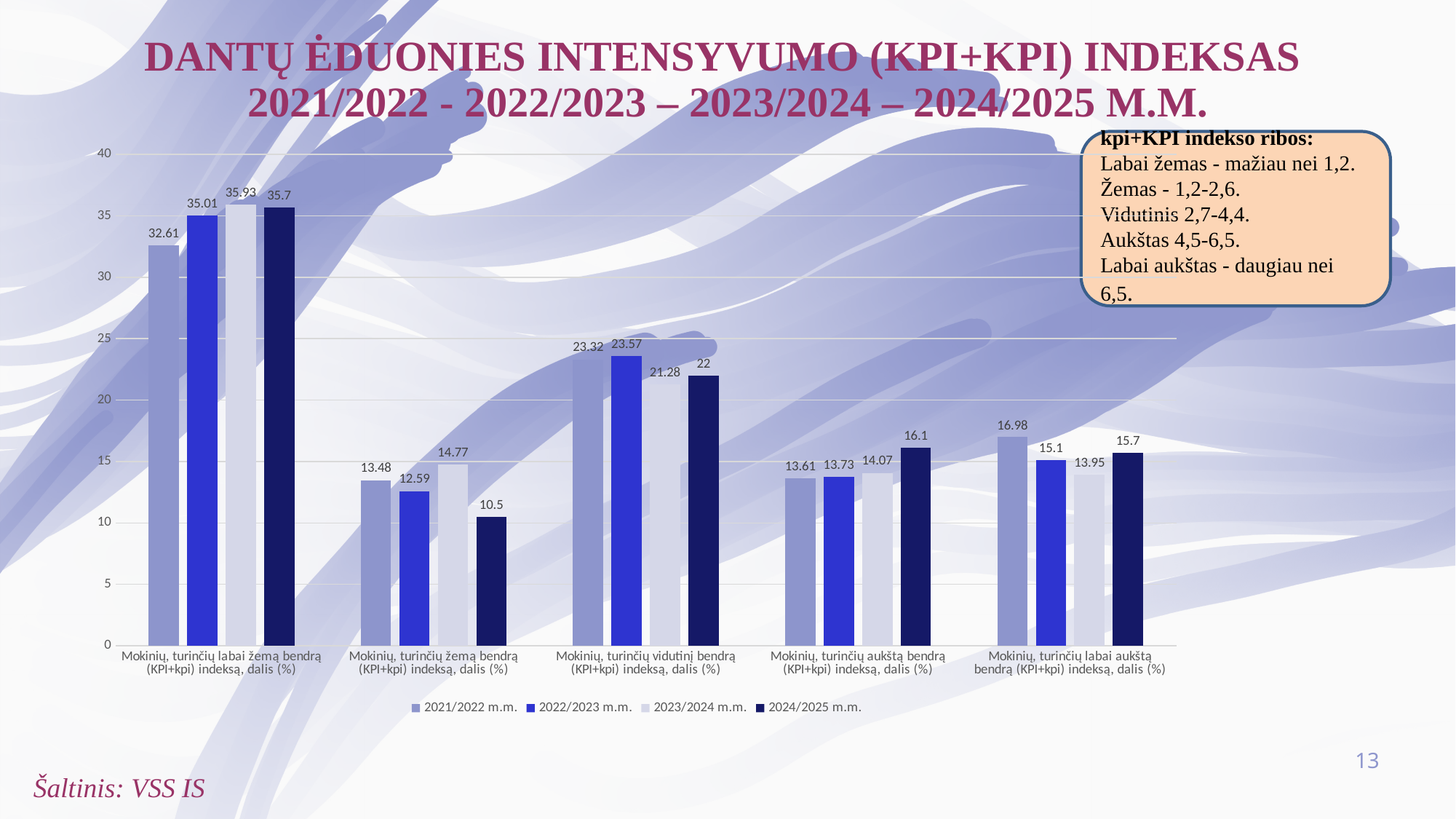
What is the value for 2021/2022 m.m. in the category 'Mokinių, turinčių labai žemą bendrą (KPI+kpi) indeksą, dalis (%)'? 32.61 Which is larger in the category 'Mokinių, turinčių vidutinį bendrą (KPI+kpi) indeksą, dalis (%)': the 2022/2023 m.m. value or the 2024/2025 m.m. value? 2022/2023 m.m. What is the value for 2024/2025 m.m. in the category 'Mokinių, turinčių žemą bendrą (KPI+kpi) indeksą, dalis (%)'? 10.5 What is the difference between the 2023/2024 m.m. and 2021/2022 m.m. values in the category 'Mokinių, turinčių labai žemą bendrą (KPI+kpi) indeksą, dalis (%)'? 3.32 What is the value for 2023/2024 m.m. in the category 'Mokinių, turinčių vidutinį bendrą (KPI+kpi) indeksą, dalis (%)'? 21.28 Which category has the highest values overall in the chart? Mokinių, turinčių labai žemą bendrą (KPI+kpi) indeksą, dalis (%) How many series does the chart legend list? 4 Which series has the highest value in the category 'Mokinių, turinčių aukštą bendrą (KPI+kpi) indeksą, dalis (%)'? 2024/2025 m.m. Is the 2021/2022 m.m. value for 'Mokinių, turinčių labai aukštą bendrą (KPI+kpi) indeksą, dalis (%)' greater or less than 15? greater How many categories are shown on the x axis of the chart? 5 What kind of chart is shown on the slide? Bar chart Which series has the lowest value in the category 'Mokinių, turinčių labai aukštą bendrą (KPI+kpi) indeksą, dalis (%)'? 2023/2024 m.m.